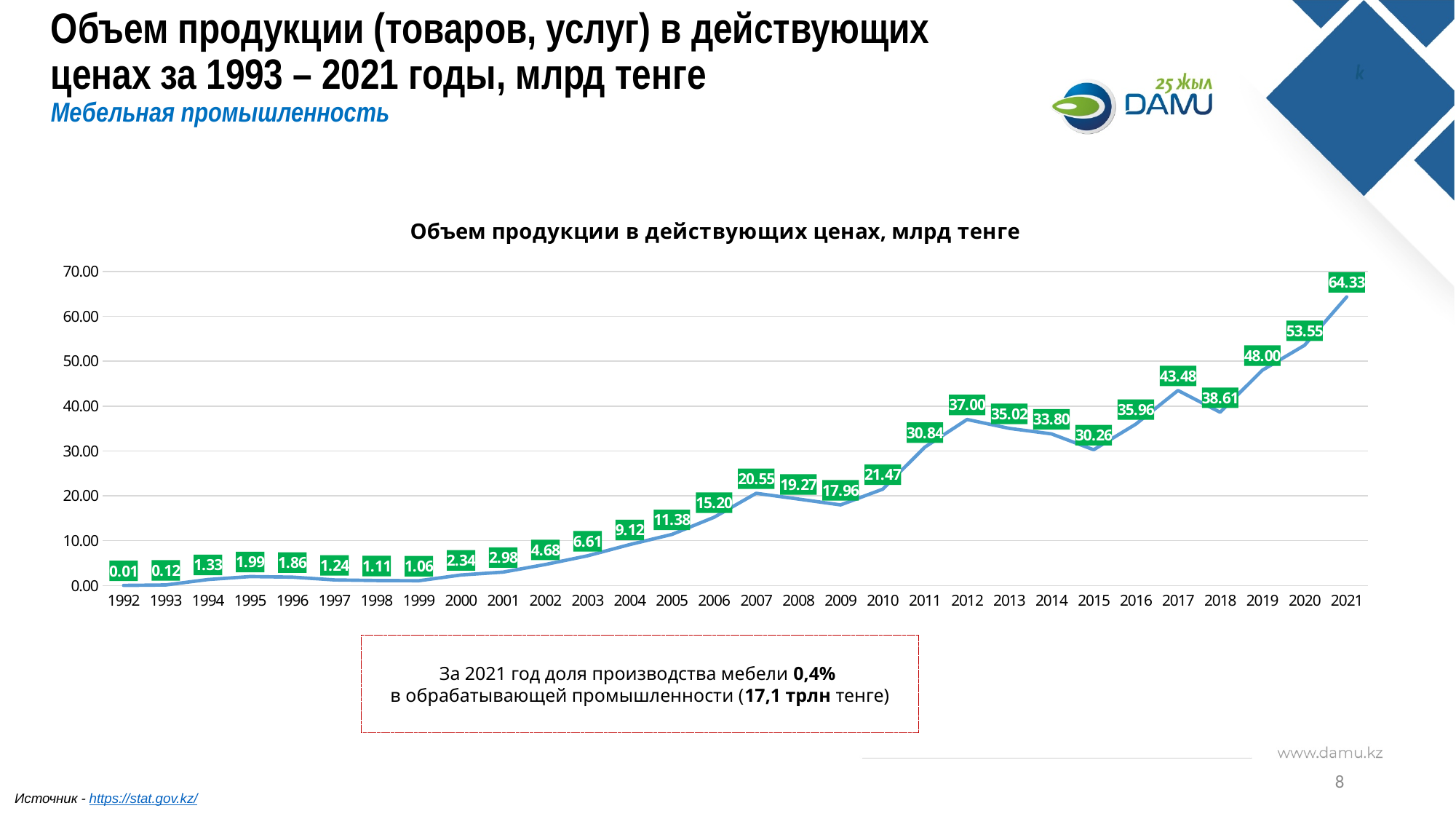
How many years are plotted on the chart? 30 What is the value for 2012? 37.00 What is the difference between the values for 2017 and 2018? 4.87 Is the value for 2019 greater or less than 40.00? greater Which year has the lowest value? 1992 Which is larger, the value for 2012 or the value for 2016? 2012 What is the title of the chart? Объем продукции в действующих ценах, млрд тенге What is the value for 2021? 64.33 What is the value for 2007? 20.55 What kind of chart is shown on the slide? line chart Which year has the highest value? 2021 What is the difference between the values for 2021 and 2020? 10.78